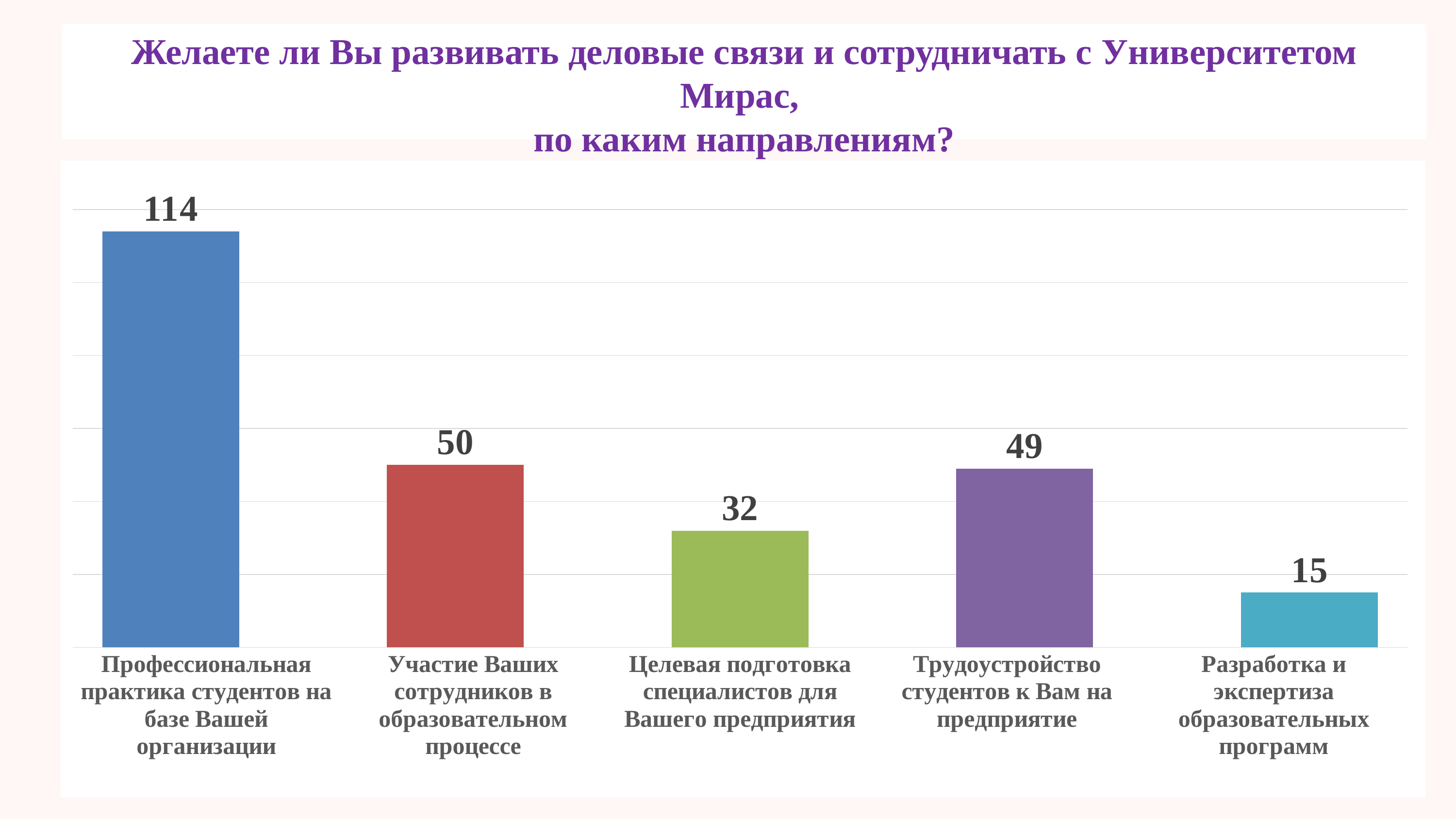
Which category has the highest value? Профессиональная практика студентов на базе Вашей организации Which is larger: the value for «Трудоустройство студентов к Вам на предприятие» or the value for «Целевая подготовка специалистов для Вашего предприятия»? Трудоустройство студентов к Вам на предприятие What is the value for «Разработка и экспертиза образовательных программ»? 15 What is the value for «Целевая подготовка специалистов для Вашего предприятия»? 32 What is the value for «Трудоустройство студентов к Вам на предприятие»? 49 Which category has the lowest value? Разработка и экспертиза образовательных программ What is the value for «Участие Ваших сотрудников в образовательном процессе»? 50 What is the value for «Профессиональная практика студентов на базе Вашей организации»? 114 What is the difference between the values for «Профессиональная практика студентов на базе Вашей организации» and «Участие Ваших сотрудников в образовательном процессе»? 64 What is the difference between the values for «Целевая подготовка специалистов для Вашего предприятия» and «Разработка и экспертиза образовательных программ»? 17 What kind of chart is shown on the slide? Bar chart How many categories are shown in the chart? 5